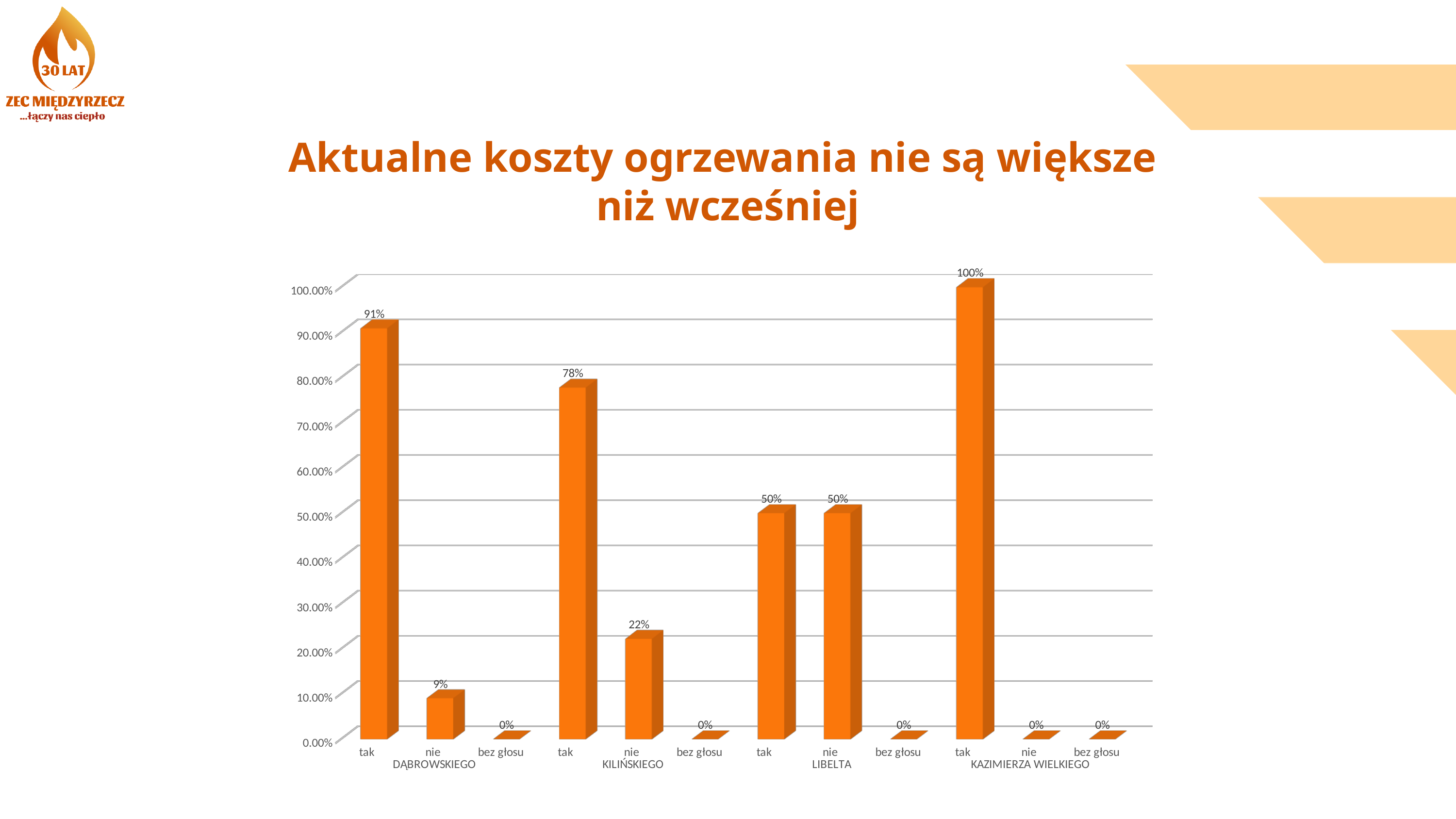
What is the value for "nie" in the KILIŃSKIEGO group? 22% Which group has the lowest "tak" value? LIBELTA Which is larger: "tak" for DĄBROWSKIEGO or "tak" for KILIŃSKIEGO? tak for DĄBROWSKIEGO What is the value for "nie" in the DĄBROWSKIEGO group? 9% Which group has the highest "tak" value? KAZIMIERZA WIELKIEGO What kind of chart is shown on the slide? bar chart How many bars are plotted in the chart? 12 What is the difference between the "tak" and "nie" values in the KILIŃSKIEGO group? 56% What is the title of the slide? Aktualne koszty ogrzewania nie są większe niż wcześniej How many street groups are shown on the x axis? 4 What is the value for "tak" in the KAZIMIERZA WIELKIEGO group? 100% What is the value for "tak" in the DĄBROWSKIEGO group? 91%